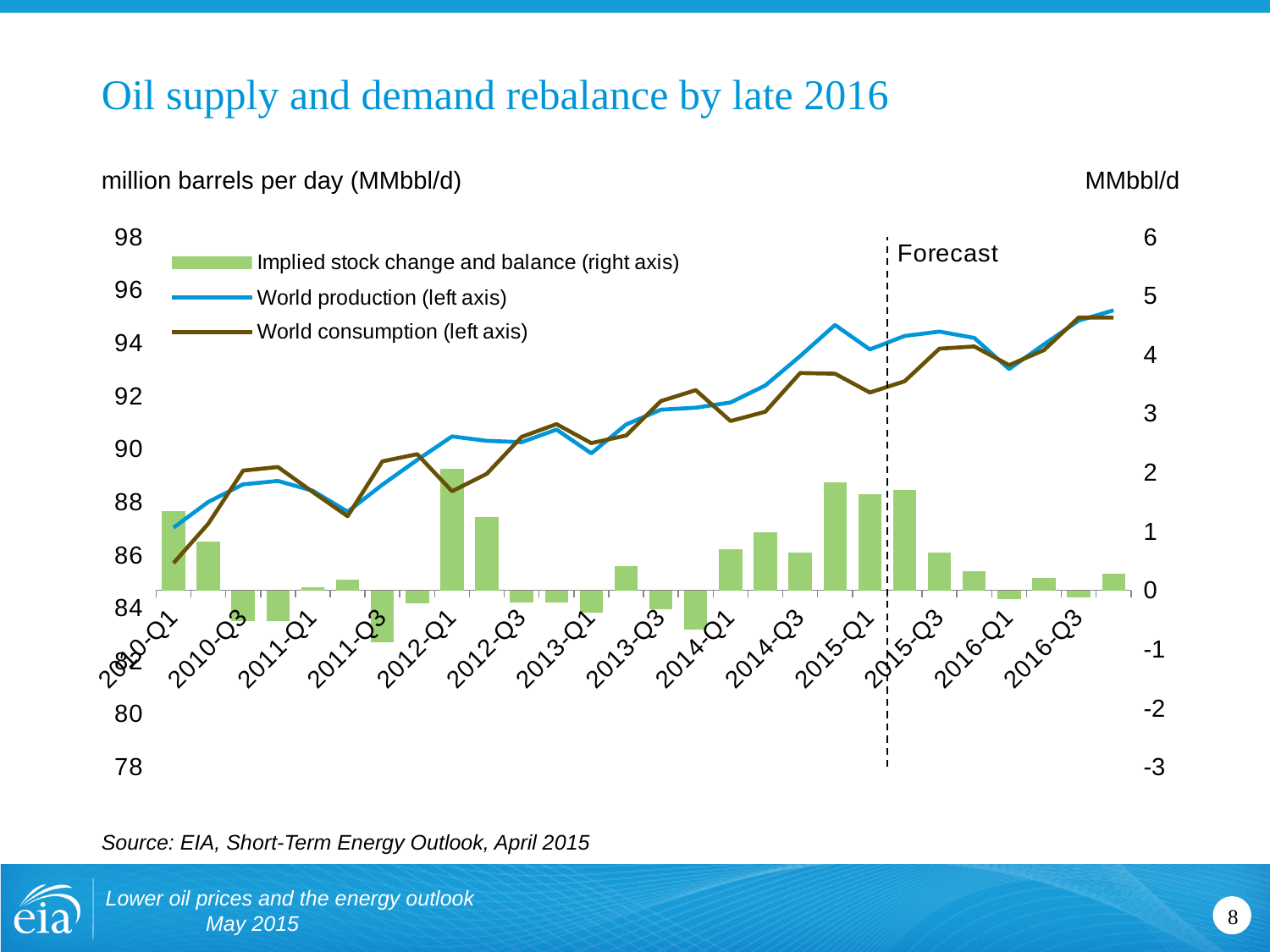
Does World consumption generally rise or fall from 2010-Q1 to 2016-Q4? rise Is the Implied stock change and balance bar for 2011-Q3 greater or less than 0? less How many quarter labels are shown on the x axis? 14 What kind of chart is shown on the slide? A combined bar and line chart In 2010-Q1, which is higher, World production or World consumption? World production How many series does the chart legend list? 3 Is the value for World production in 2010-Q1 greater or less than 90? less In 2014-Q4, which is higher, World production or World consumption? World production Is the Implied stock change and balance bar for 2012-Q1 greater or less than 1? greater What is the title of the chart on the slide? Oil supply and demand rebalance by late 2016 Which series is plotted as bars on the right axis? Implied stock change and balance